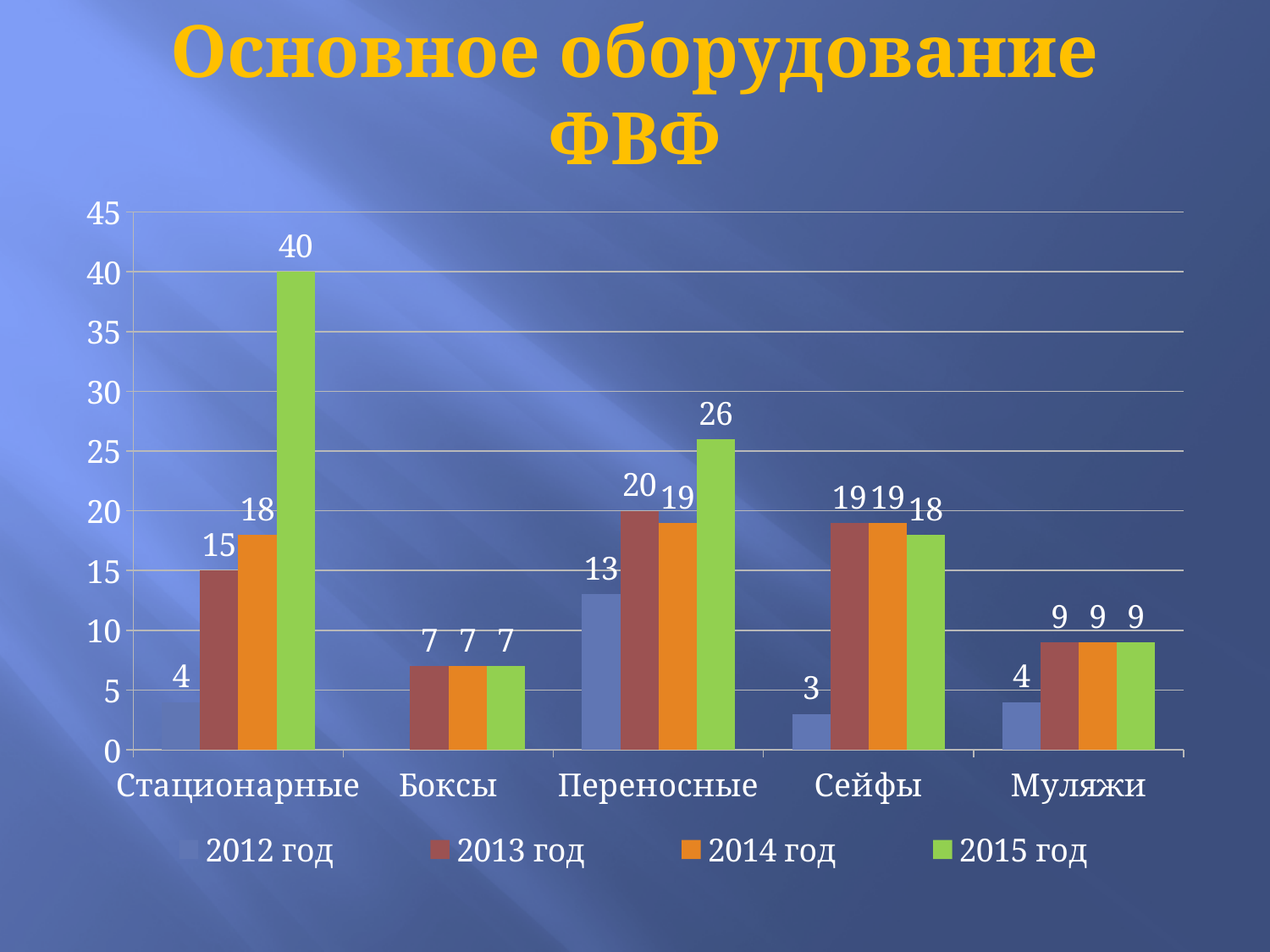
Which is larger for Переносные: the 2013 год value or the 2014 год value? 2013 год What is the value for Переносные in 2012 год? 13 How many categories are shown on the x axis? 5 What is the value for Стационарные in 2015 год? 40 How many series does the legend list? 4 Which category has the lowest value in 2012 год among those with a bar shown? Сейфы What is the value for Муляжи in 2013 год? 9 What is the difference between the 2015 год and 2012 год values for Стационарные? 36 What is the value for Сейфы in 2015 год? 18 What is the title of the chart on the slide? Основное оборудование ФВФ Which category has the highest value in 2015 год? Стационарные What kind of chart is shown on the slide? Bar chart